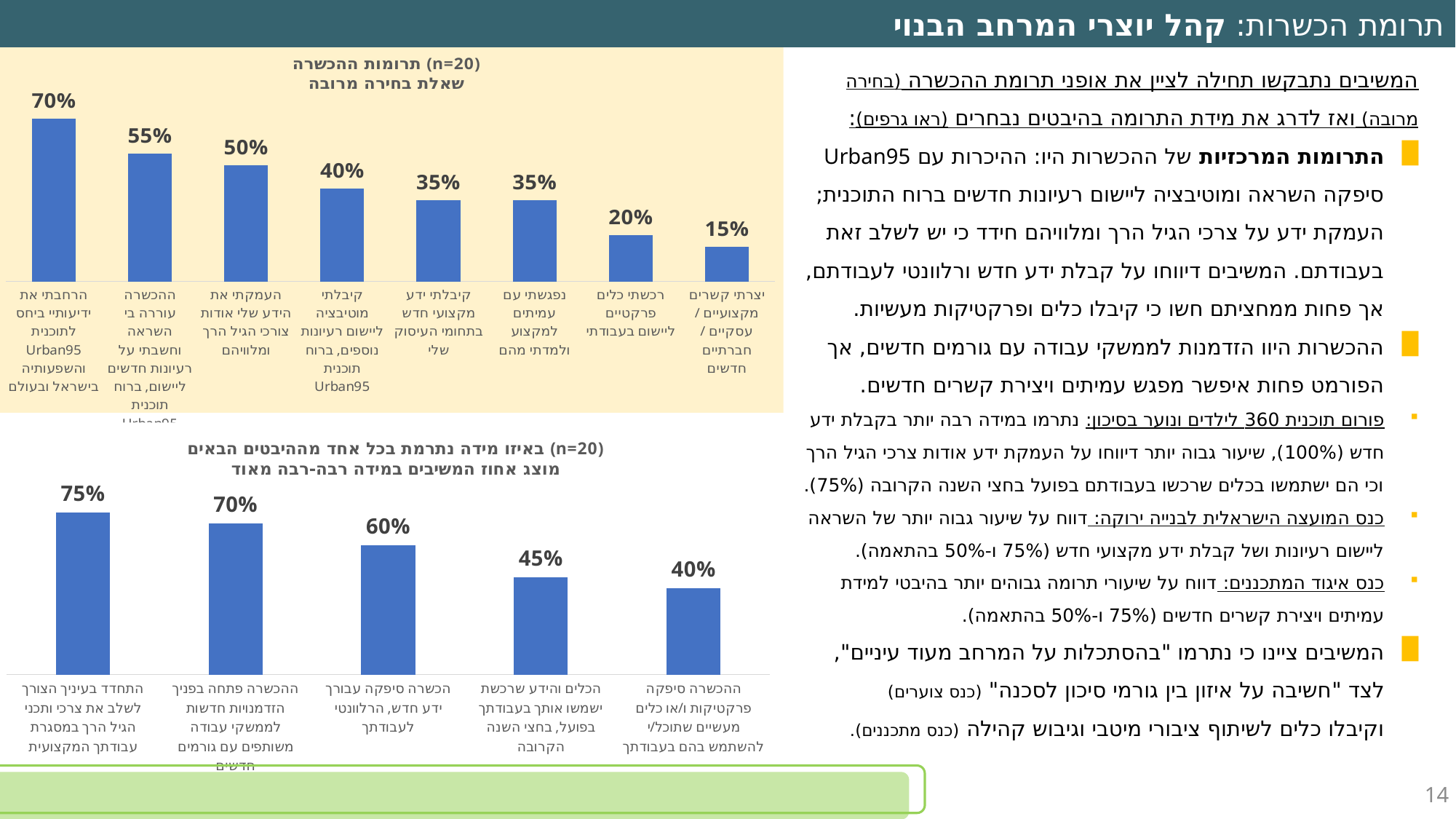
In the bottom chart (באיזו מידה נתרמת), which category has the highest value? התחדד בעיניך הצורך לשלב את צרכי ותכני הגיל הרך במסגרת עבודתך המקצועית In the top chart (תרומות ההכשרה), what is the difference between 'ההכשרה עוררה בי השראה' (55%) and 'קיבלתי מוטיבציה ליישום רעיונות נוספים' (40%)? 15% In the top chart (תרומות ההכשרה), which category has the lowest value? יצרתי קשרים מקצועיים / עסקיים / חברתיים חדשים In the bottom chart (באיזו מידה נתרמת), what is the value for 'הכשרה סיפקה עבורך ידע חדש, הרלוונטי לעבודתך'? 60% In the top chart (תרומות ההכשרה), do the values rise or fall from left to right? fall In the bottom chart (באיזו מידה נתרמת), how many categories are shown? 5 In the top chart (תרומות ההכשרה), what is the value for 'רכשתי כלים פרקטיים ליישום בעבודתי'? 20% In the bottom chart (באיזו מידה נתרמת), which is larger: 'הכלים והידע שרכשת ישמשו אותך בעבודתך בפועל' or 'ההכשרה סיפקה פרקטיקות ו/או כלים מעשיים'? הכלים והידע שרכשת ישמשו אותך בעבודתך בפועל What type of chart is the bottom chart (באיזו מידה נתרמת)? bar chart In the bottom chart (באיזו מידה נתרמת), what is the difference between the highest value (75%) and the lowest value (40%)? 35% In the top chart (תרומות ההכשרה), what is the value for 'הרחבתי את ידיעותי ביחס לתוכנית Urban95 והשפעותיה בישראל ובעולם'? 70% In the top chart (תרומות ההכשרה), how many categories are shown? 8